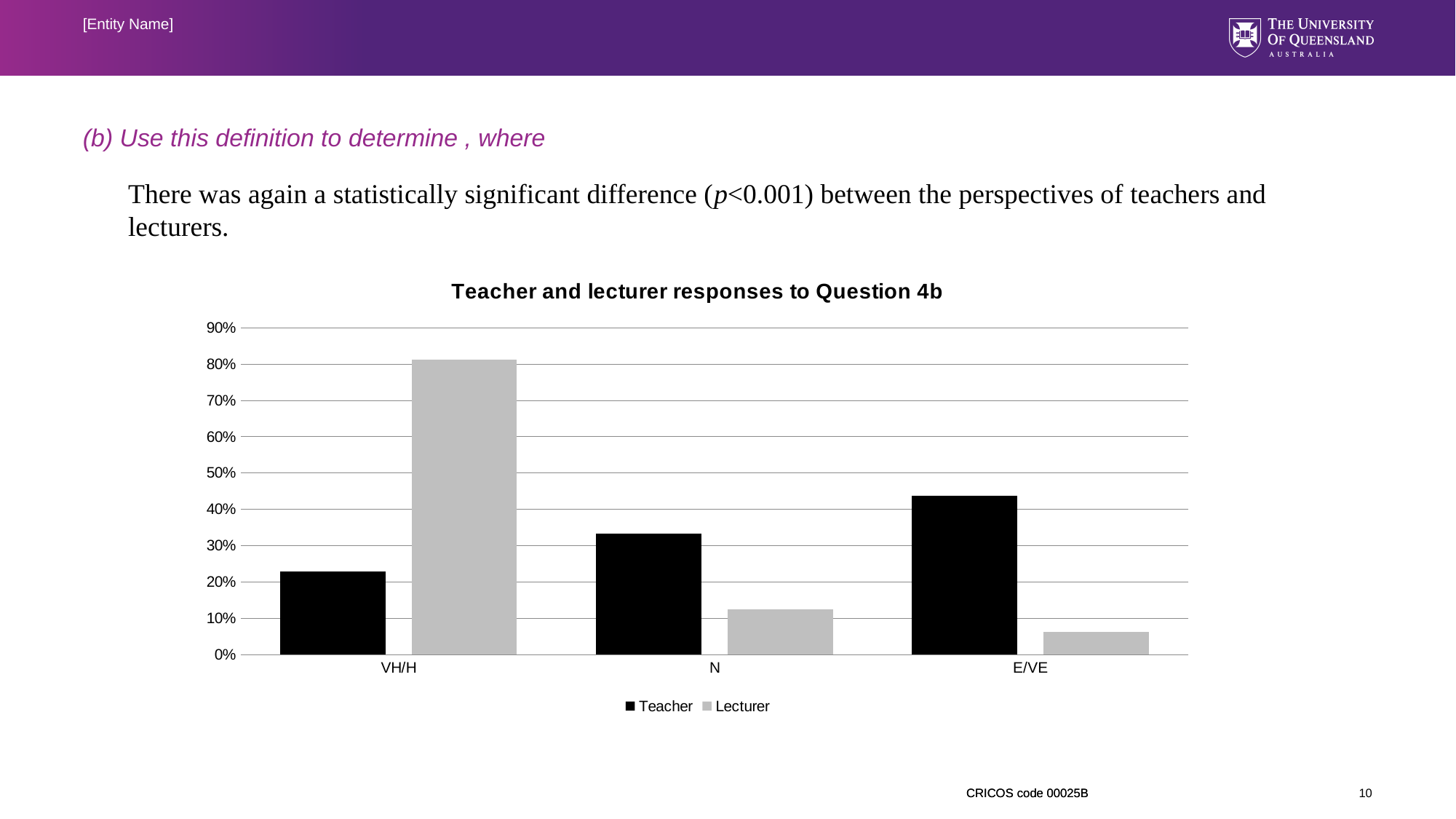
Is the Lecturer value for VH/H greater or less than 80%? greater Which category has the lowest Lecturer value? E/VE Which category has the highest Lecturer value? VH/H What type of chart is shown on the slide? Bar chart Do the Lecturer values rise or fall from VH/H to E/VE? Fall Which category has the lowest Teacher value? VH/H Which category has the highest Teacher value? E/VE Which is larger for E/VE, the Teacher value or the Lecturer value? Teacher What is the title of the chart? Teacher and lecturer responses to Question 4b Is the Teacher value for N greater or less than 30%? greater How many series does the legend list? 2 How many categories are shown on the x axis? 3